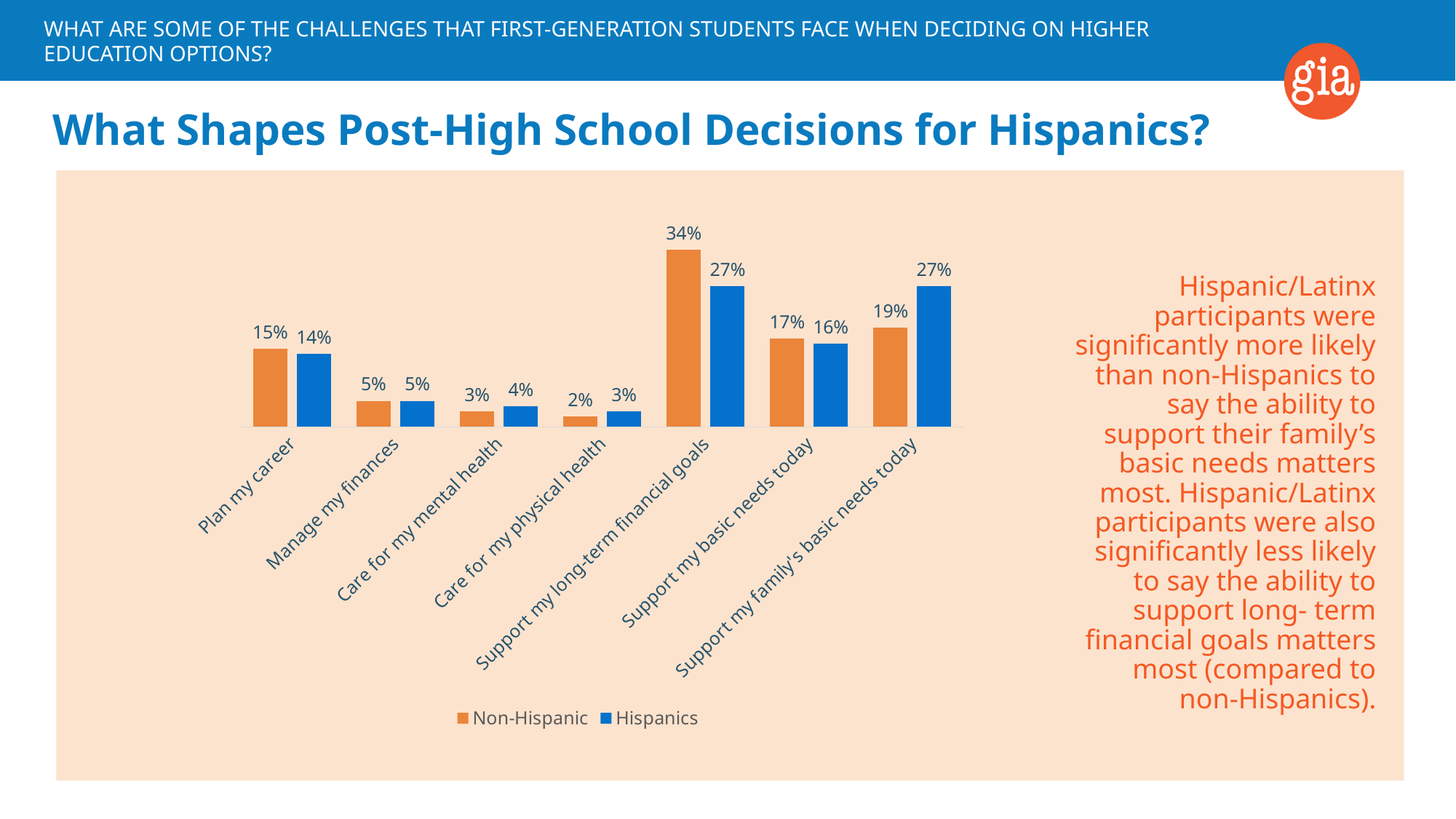
Which category has the highest Non-Hispanic value? Support my long-term financial goals How many categories are shown on the x axis? 7 What is the difference between the Non-Hispanic and Hispanics values for "Support my long-term financial goals"? 7% What is the Hispanics value for "Plan my career"? 14% How many series does the legend list? 2 Which category has the lowest Non-Hispanic value? Care for my physical health What is the Non-Hispanic value for "Support my long-term financial goals"? 34% What is the Hispanics value for "Support my family's basic needs today"? 27% Which colour represents the Hispanics series in the chart? Blue What kind of chart is shown on the slide? Bar chart What is the difference between the Hispanics and Non-Hispanic values for "Support my family's basic needs today"? 8% For "Support my basic needs today", which series has the larger value, Non-Hispanic or Hispanics? Non-Hispanic